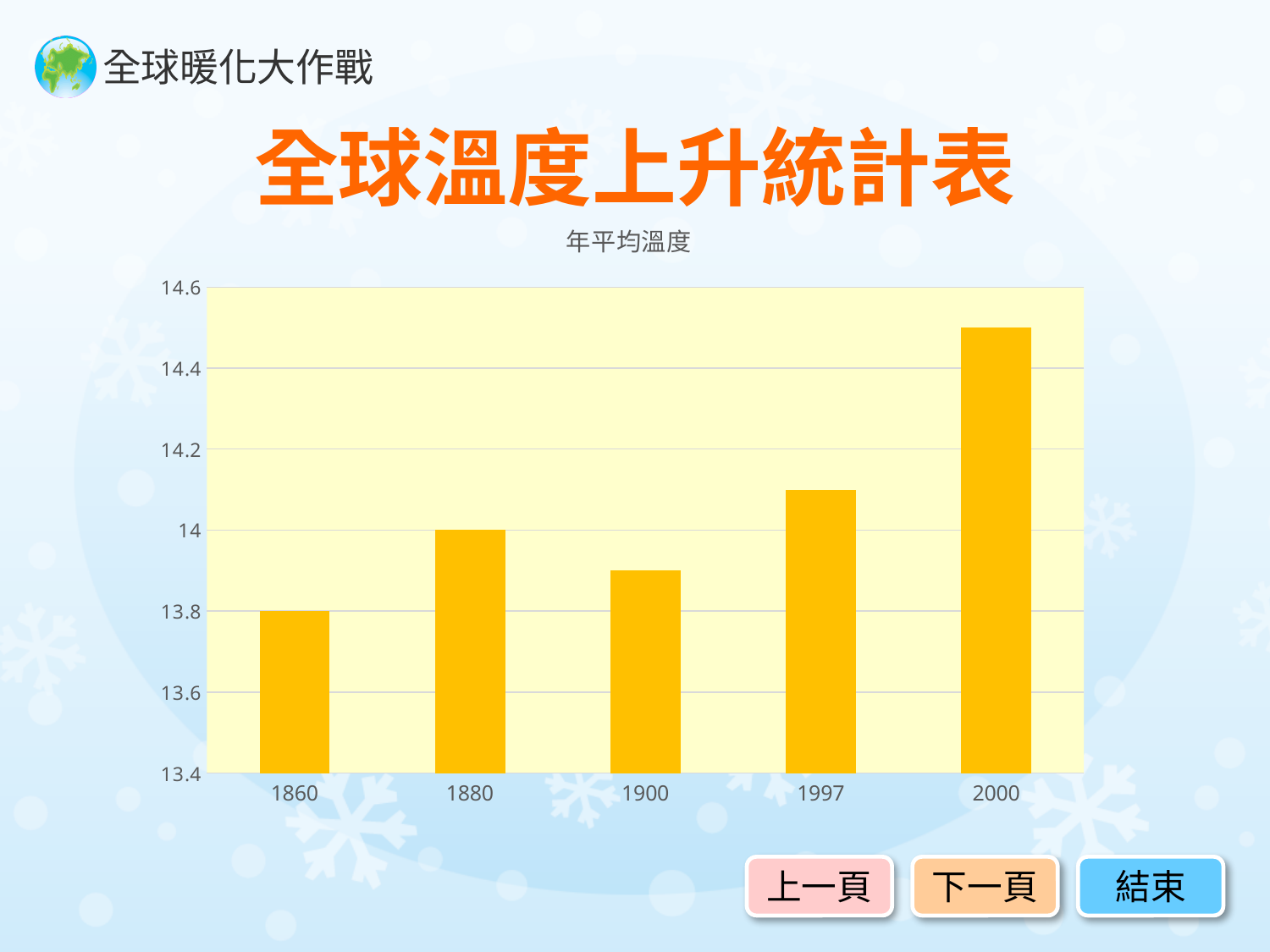
What is the value for 1860? 13.8 Is the value for 1900 greater or less than 14? less What is the difference between the values for 1880 and 1860? 0.2 What is the chart's title shown above the plot area? 年平均溫度 Which year has the highest value? 2000 What kind of chart is shown on the slide? bar chart Is the value for 2000 greater or less than 14.4? greater How many years (categories) are plotted on the x axis? 5 Which year has the lowest value? 1860 Which has the larger value, 1900 or 1997? 1997 Is the value for 1997 greater or less than 14? greater What is the value for 1880? 14